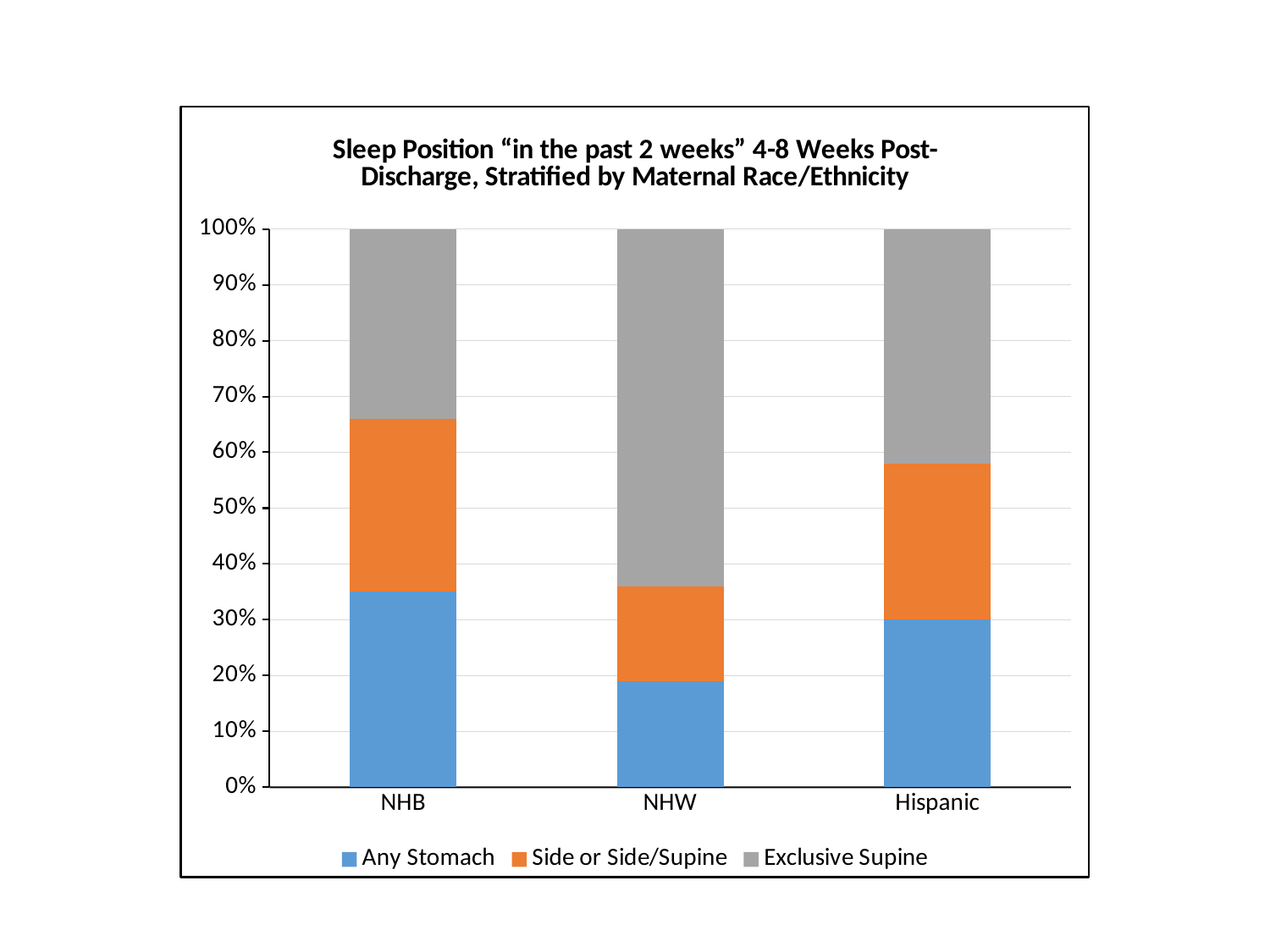
Is the Exclusive Supine value for NHW greater or less than 60%? greater Which series is shown in orange? Side or Side/Supine Which category has the smallest Any Stomach share? NHW Is the Any Stomach value for NHB greater or less than 30%? greater What is the total height of each stacked bar? 100% Which is larger, the Any Stomach share for Hispanic or for NHW? Hispanic Which category has the largest Any Stomach share? NHB Which category has the largest Exclusive Supine share? NHW What kind of chart is shown on the slide? Stacked bar chart How many categories are shown on the x axis? 3 How many series does the legend list? 3